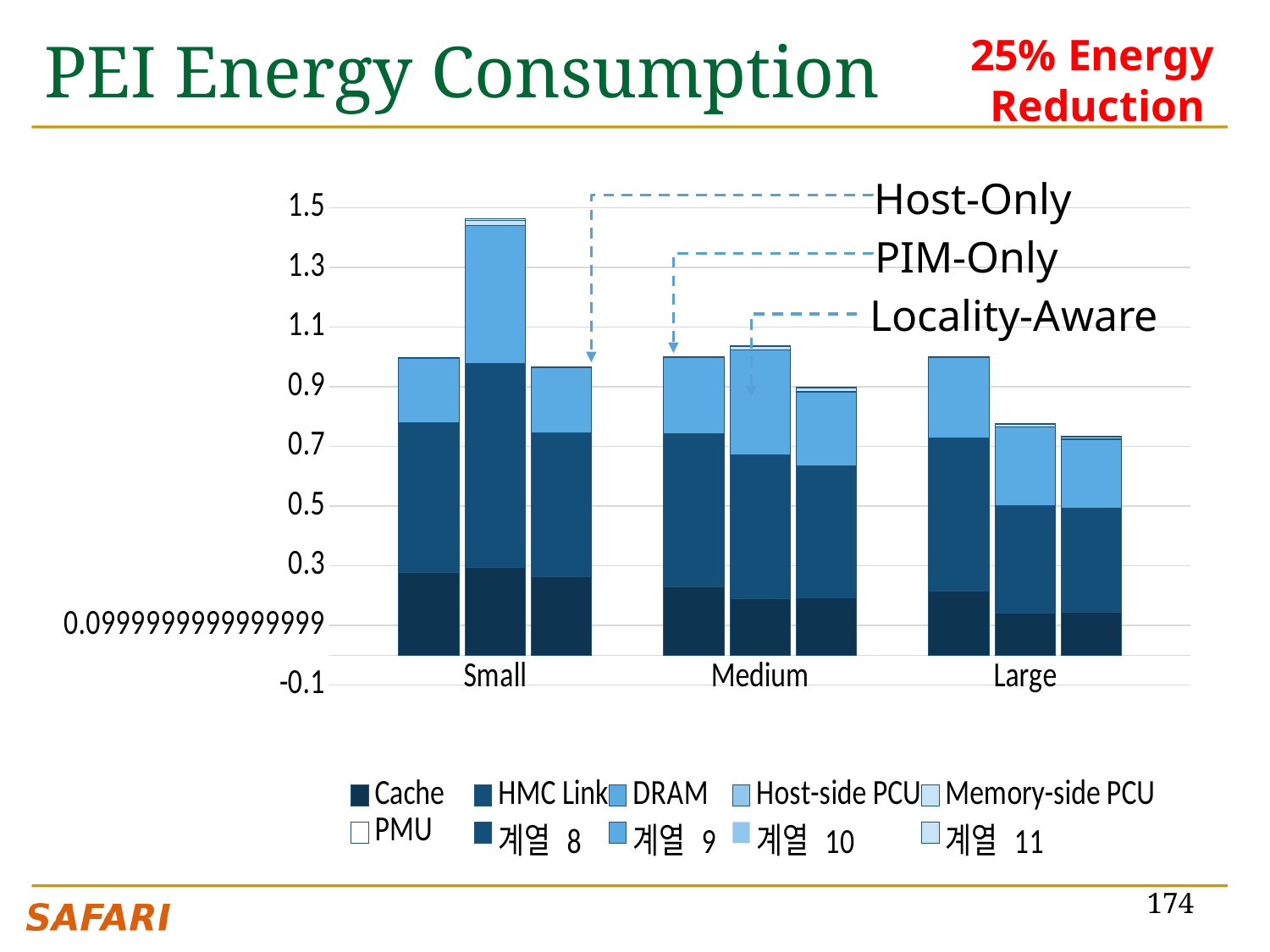
What is the title of the chart on the slide? PEI Energy Consumption How many categories are shown on the x axis of the chart? 3 What energy reduction is stated in red at the top right of the slide? 25% Energy Reduction How many series does the chart's legend list? 10 Which category group contains the tallest bar in the chart? Small In the Small group, which is larger: the Host-Only bar or the PIM-Only bar? PIM-Only Is the total value of the PIM-Only bar for Medium greater or less than 1.1? less Is the total value of the Locality-Aware bar for Large greater or less than 0.9? less Is the total value of the PIM-Only bar for Small greater or less than 1.3? greater In the Large group, which is larger: the Host-Only bar or the PIM-Only bar? Host-Only Do the Locality-Aware bars rise or fall from Small to Large? fall What kind of chart is shown on the slide? stacked bar chart